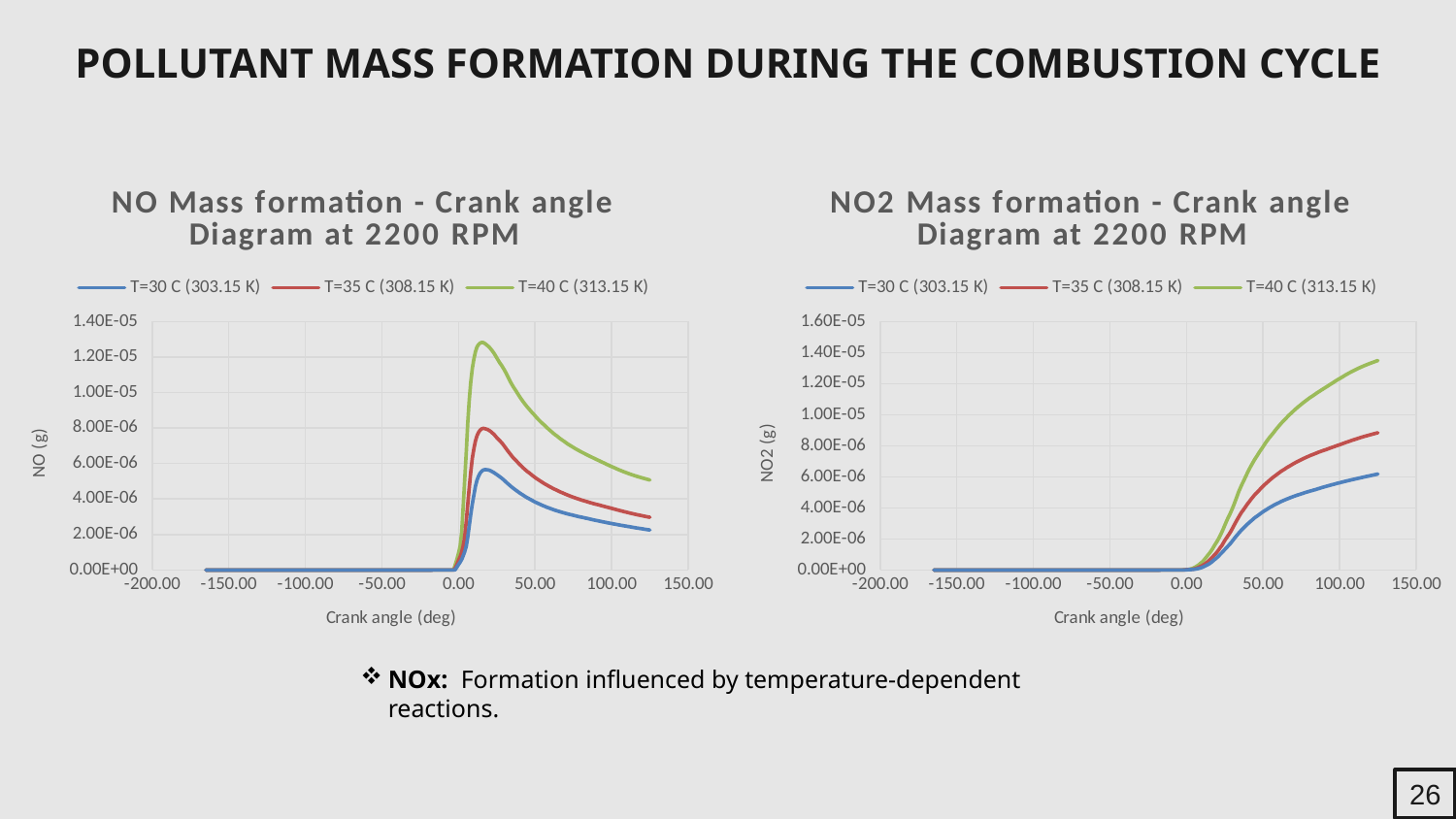
In the NO2 Mass formation chart, do the values rise or fall as the crank angle increases from 0.00 to 150.00 deg? rise In the NO Mass formation chart, do the values rise or fall as the crank angle increases from 50.00 to 150.00 deg? fall How many series does the legend of the NO2 Mass formation - Crank angle Diagram at 2200 RPM list? 3 What is the x-axis title of the NO2 Mass formation - Crank angle Diagram at 2200 RPM? Crank angle (deg) In the NO2 Mass formation chart, which series has the lowest value at the end of the crank angle range? T=30 C (303.15 K) In the NO Mass formation chart, is the peak value of the T=35 C (308.15 K) series greater or less than 1.00E-05? less In the NO2 Mass formation chart, is the final value of the T=35 C (308.15 K) series greater or less than 1.00E-05? less What kind of chart is the NO Mass formation - Crank angle Diagram at 2200 RPM? Line chart In the NO Mass formation chart, is the peak value of the T=40 C (313.15 K) series greater or less than 1.00E-05? greater In the NO2 Mass formation chart, which series is higher at a crank angle of 100.00 deg: T=30 C (303.15 K) or T=35 C (308.15 K)? T=35 C (308.15 K) In the NO Mass formation chart, which series reaches the highest peak value? T=40 C (313.15 K)